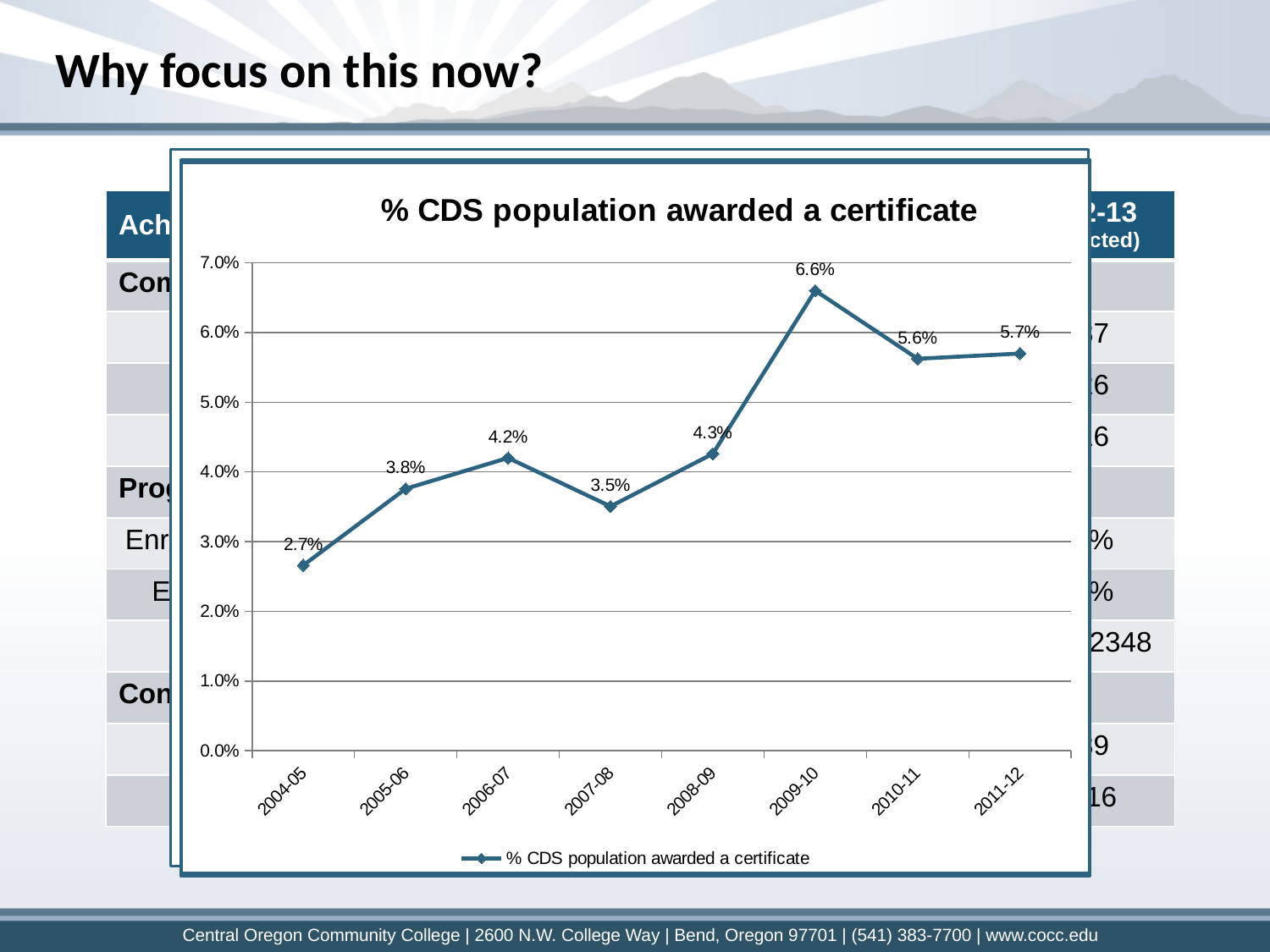
How many series does the legend list? 1 What is the value for 2007-08 in the chart? 3.5% Which is larger, the value for 2006-07 or the value for 2007-08? 2006-07 What is the title of the chart? % CDS population awarded a certificate Is the value for 2011-12 greater or less than 5.0%? greater What kind of chart is shown? line chart Which year has the highest % CDS population awarded a certificate? 2009-10 How many years are plotted on the x axis? 8 What is the difference between the values for 2009-10 and 2010-11? 1.0% Which year has the lowest % CDS population awarded a certificate? 2004-05 What is the value for 2004-05 in the chart? 2.7% What is the value for 2009-10 in the chart? 6.6%